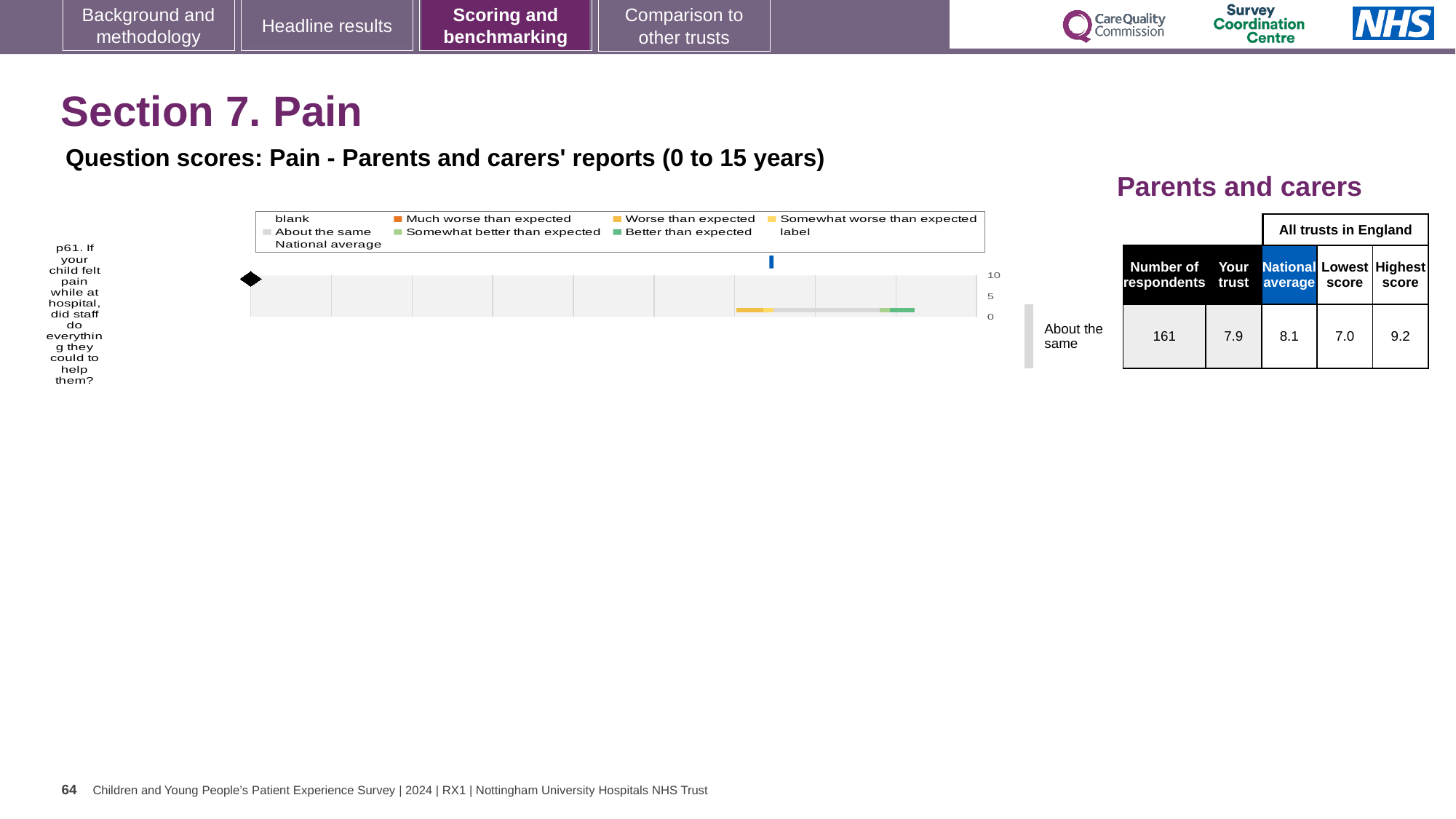
In the table next to the chart, what is the national average score? 8.1 What kind of chart is shown on the slide? bar chart In the table next to the chart, what is the highest score among all trusts in England? 9.2 In the table next to the chart, what is the lowest score among all trusts in England? 7.0 In the table next to the chart, what is the number of respondents? 161 In the table next to the chart, which is larger: the 'Your trust' score or the national average? National average What colour does the legend use for 'Better than expected'? green How many survey questions are plotted on the chart? 1 In the table next to the chart, what is the 'Your trust' score for the 'About the same' row? 7.9 What is the highest tick value shown on the chart's axis? 10 In the table next to the chart, what is the difference between the highest score and the lowest score? 2.2 Is the national average marker on the chart greater or less than 5? greater